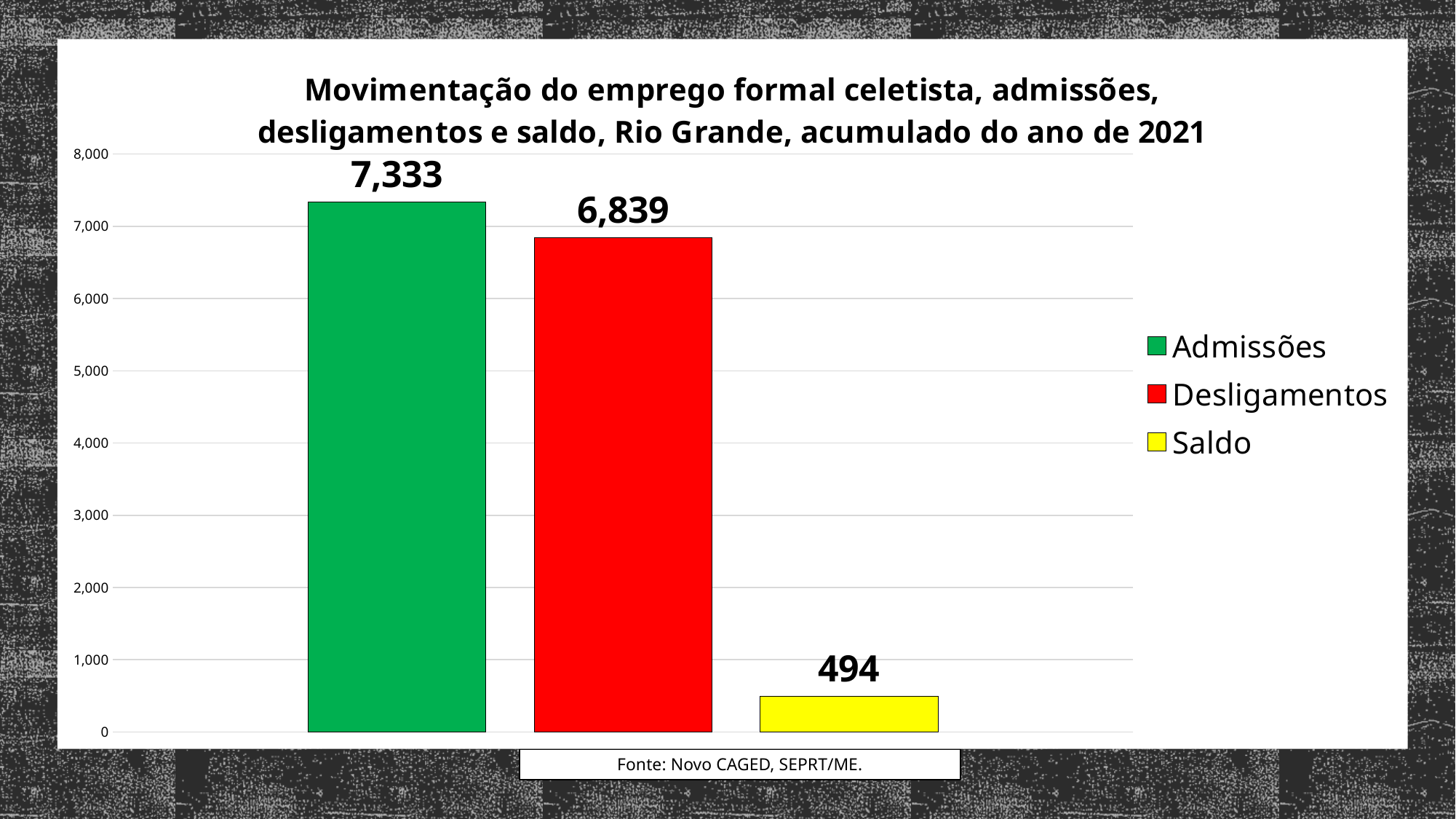
What kind of chart is shown? bar chart Which is larger, Admissões or Desligamentos? Admissões What is the difference between Admissões and Desligamentos? 494 How many series does the legend list? 3 Which series has the highest value? Admissões Is the value for Saldo greater or less than 1,000? less Which series has the lowest value? Saldo What is the value for Saldo? 494 What colour is the Saldo bar? yellow How many bars are plotted on the chart? 3 What is the value for Admissões? 7,333 What is the value for Desligamentos? 6,839